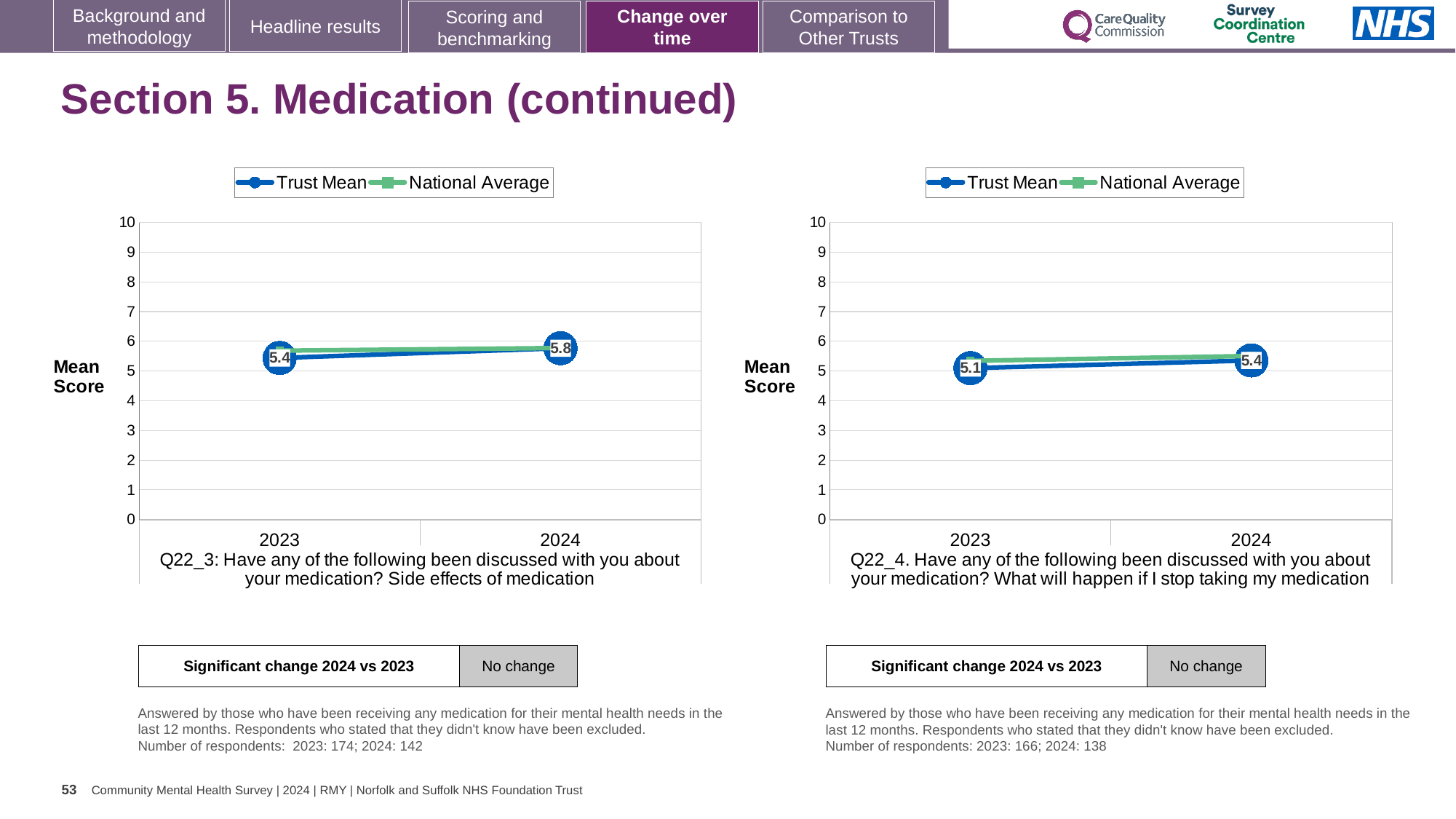
In the left chart (Q22_3), by how much did the Trust Mean change from 2023 to 2024? 0.4 What kind of chart is the right chart (Q22_4)? line chart In the right chart (Q22_4), what is the Trust Mean for 2024? 5.4 In the left chart (Q22_3), what is the Trust Mean for 2024? 5.8 In the right chart (Q22_4), does the Trust Mean rise or fall from 2023 to 2024? rise In the left chart (Q22_3), what is the Trust Mean for 2023? 5.4 In the right chart (Q22_4), what is the Trust Mean for 2023? 5.1 In the right chart (Q22_4), by how much did the Trust Mean change from 2023 to 2024? 0.3 How many years are plotted on the x axis of the left chart (Q22_3)? 2 In the right chart (Q22_4), is the Trust Mean for 2023 greater or less than 6? less In the left chart (Q22_3), does the Trust Mean rise or fall from 2023 to 2024? rise How many series does the legend of the left chart list? 2